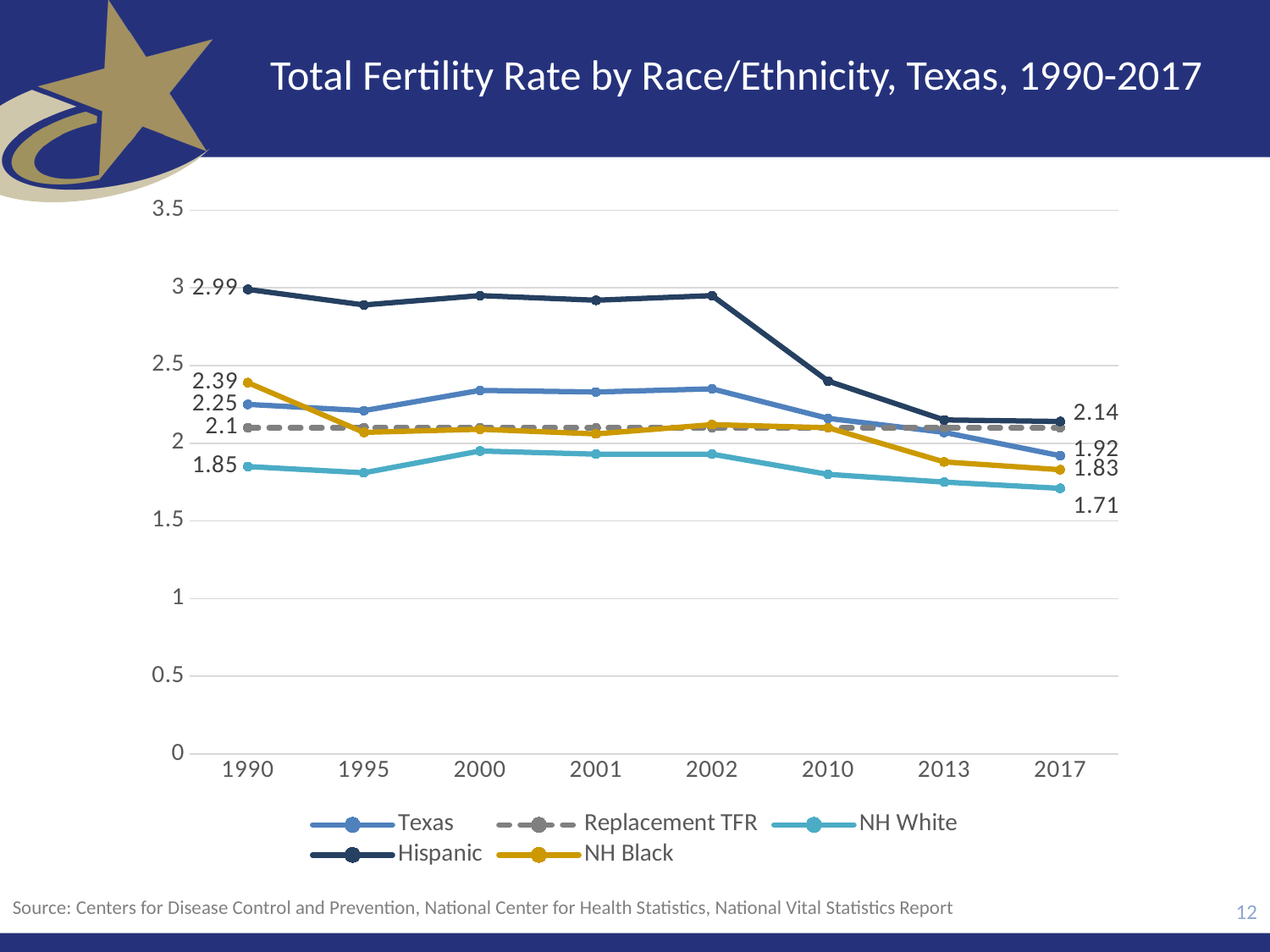
How many years are shown along the x axis? 8 How many series does the legend list? 5 What was the total fertility rate for NH Black in 1990? 2.39 What kind of chart is shown on the slide? Line chart Is the Hispanic value in 2010 greater or less than 2.5? less What was the total fertility rate for NH White in 2017? 1.71 What was the total fertility rate for Texas in 1990? 2.25 Does the Hispanic total fertility rate rise or fall from 1990 to 2017? Fall Which group had the highest total fertility rate in 1990? Hispanic Which group had the lowest total fertility rate in 2017? NH White By how much did the Hispanic total fertility rate fall from 1990 to 2017? 0.85 What was the total fertility rate for Hispanic in 1990? 2.99